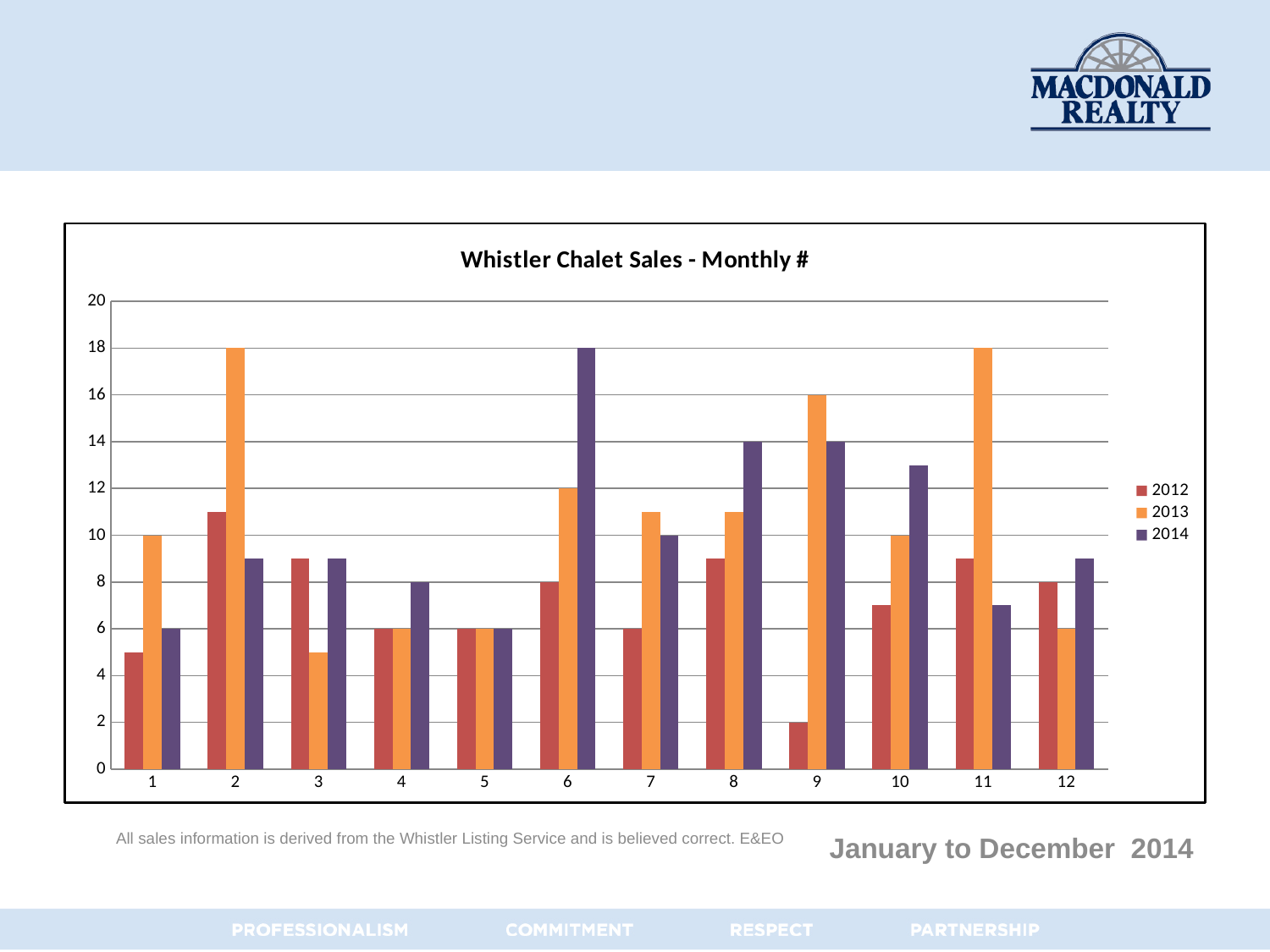
How many months (categories) are shown on the x axis? 12 How many series does the legend list? 3 In which month is the 2012 value lowest? 9 What is the value for 2014 in month 6? 18 What is the title of the chart? Whistler Chalet Sales - Monthly # What is the value for 2012 in month 9? 2 In which month is the 2014 value highest? 6 In month 9, what is the difference between the 2013 value and the 2012 value? 14 What kind of chart is shown on the slide? bar chart In month 8, which is larger: the 2014 value or the 2012 value? 2014 Is the value for 2014 in month 10 greater or less than 12? greater What is the value for 2013 in month 9? 16